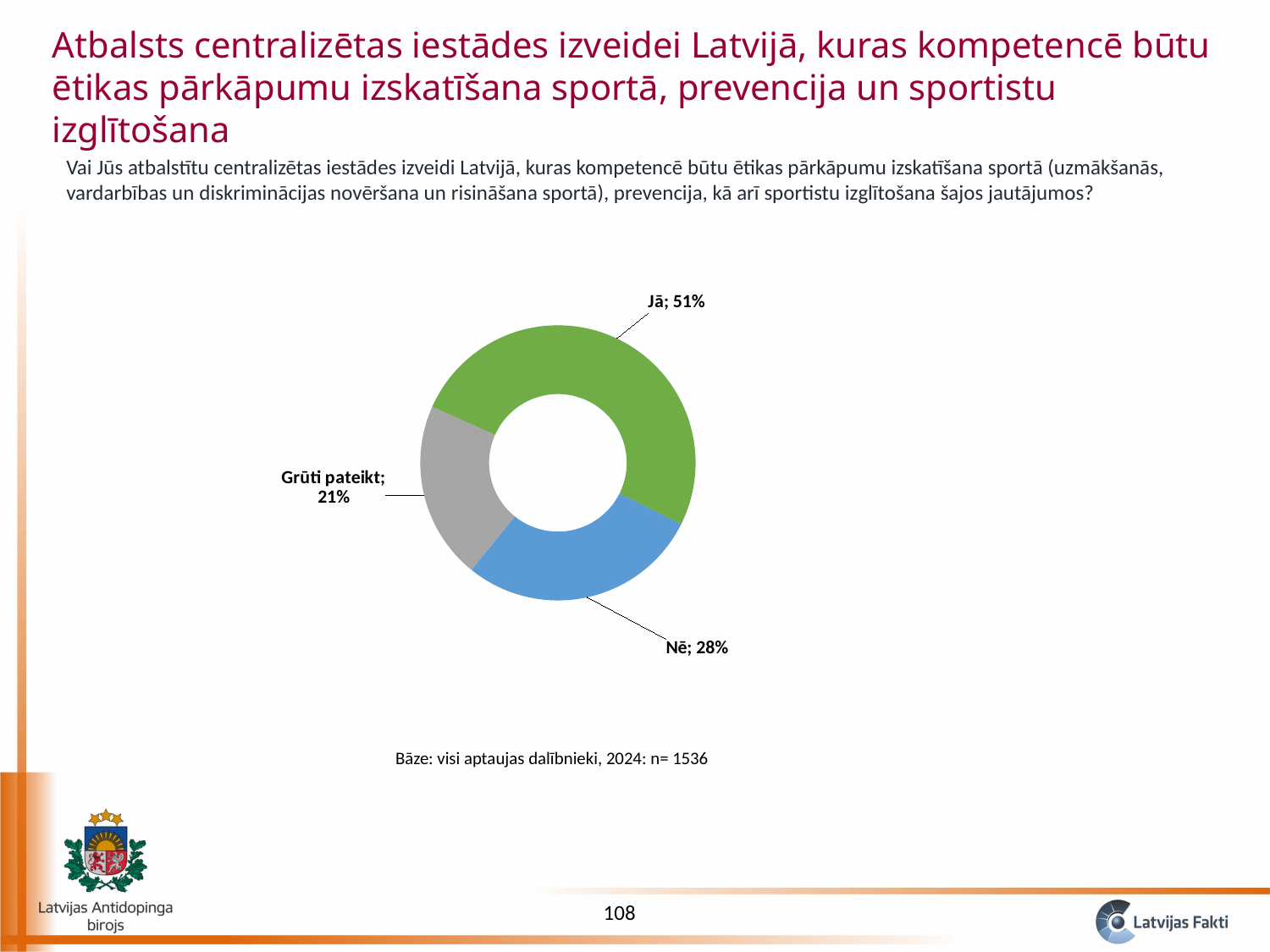
What kind of chart is shown on the slide? Doughnut (pie) chart What is the difference in percentage points between "Nē" and "Grūti pateikt"? 7 What is the difference in percentage points between "Jā" and "Nē"? 23 Which response category has the smallest share? Grūti pateikt Which response category has the largest share? Jā What is the sample size (n) stated below the chart? 1536 How many categories are shown in the chart? 3 Which is larger, the share for "Nē" or the share for "Grūti pateikt"? Nē What percentage of respondents answered "Nē"? 28% What colour is the "Jā" segment of the chart? Green What percentage of respondents answered "Jā"? 51% What percentage of respondents answered "Grūti pateikt"? 21%